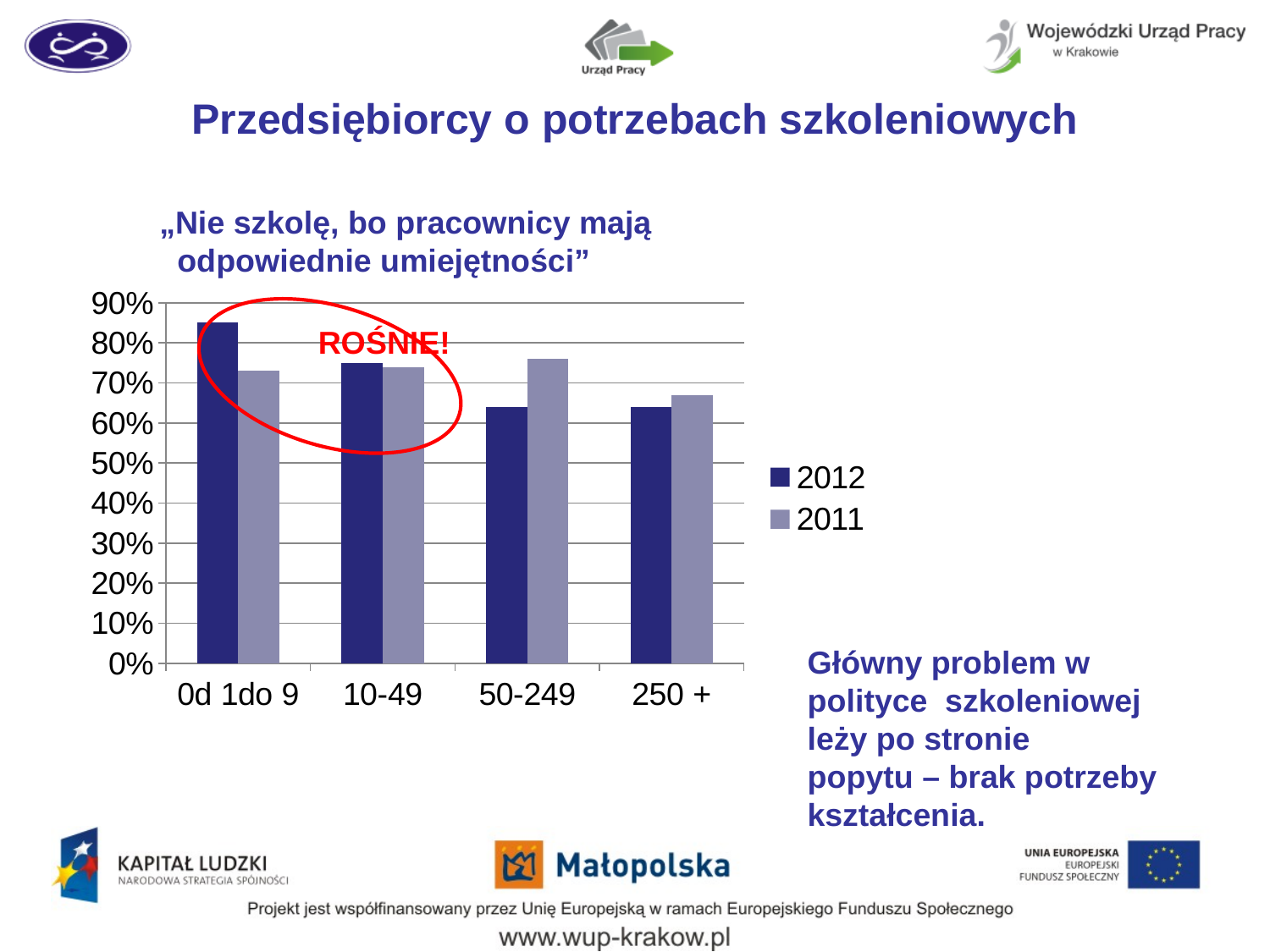
How many categories are shown on the x axis of the chart? 4 What kind of chart is shown on the slide? bar chart Is the 2012 value for 0d 1do 9 greater or less than 80%? greater Is the 2012 value for 50-249 greater or less than 70%? less For the category 0d 1do 9, which series has the larger value, 2012 or 2011? 2012 For the category 50-249, which series has the larger value, 2012 or 2011? 2011 Is the 2011 value for 50-249 greater or less than 70%? greater Which category has the highest value for the 2012 series? 0d 1do 9 Which category has the lowest value for the 2011 series? 250 + How many series does the chart's legend list? 2 Which series are listed in the chart's legend? 2012 and 2011